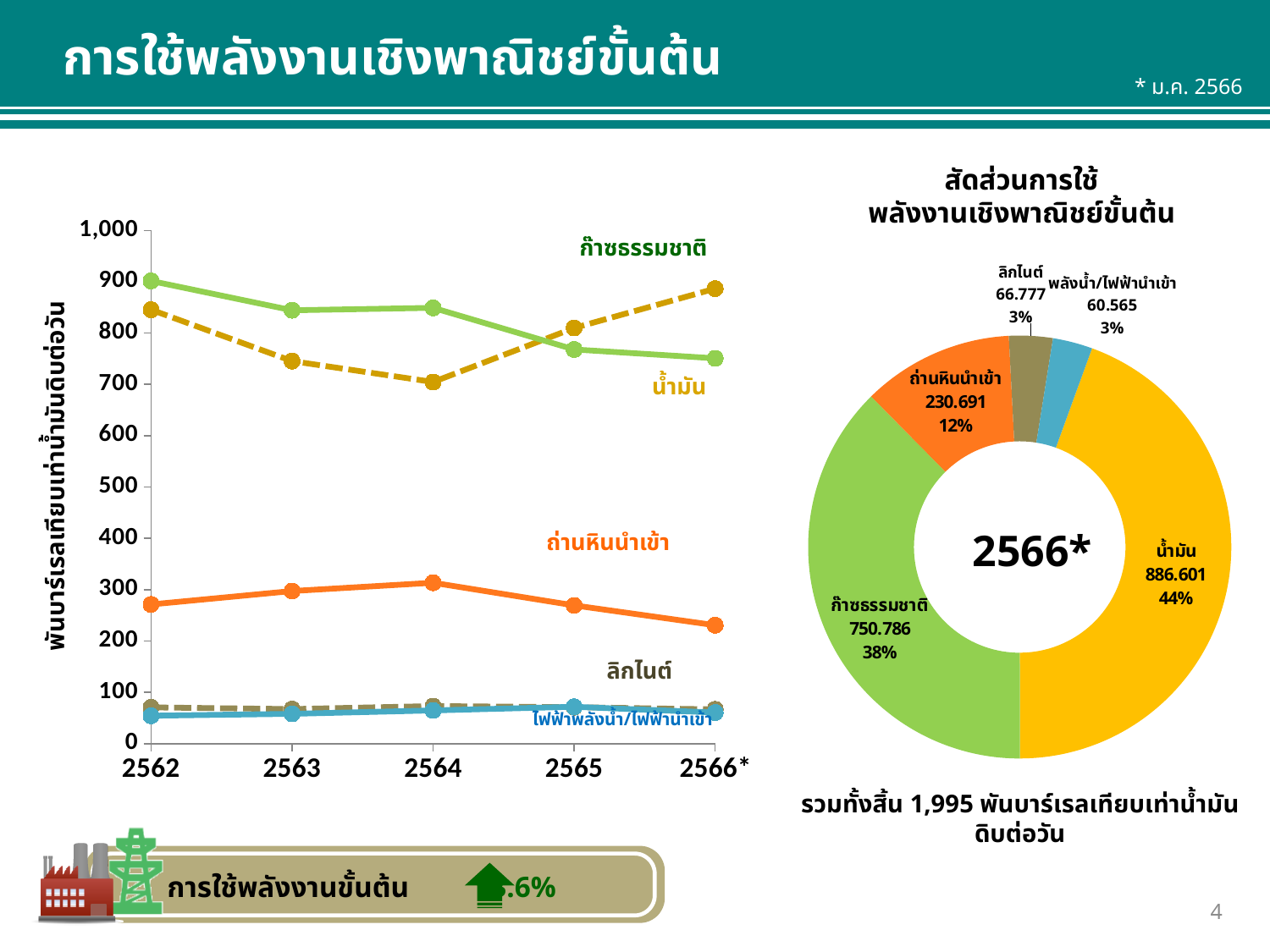
In the donut chart on the right, what share of the total does ก๊าซธรรมชาติ account for? 38% What kind of chart is the chart on the left of the slide? Line chart In the donut chart on the right, which category has the smallest value? พลังน้ำ/ไฟฟ้านำเข้า How many slices does the donut chart on the right have? 5 In the donut chart on the right, what share does ถ่านหินนำเข้า account for? 12% In the line chart on the left, does the value for ถ่านหินนำเข้า rise or fall from 2564 to 2566*? fall In the donut chart on the right, which category has the largest slice? น้ำมัน In the line chart on the left, is the value for ก๊าซธรรมชาติ in 2562 greater or less than 800? greater How many years are shown on the x axis of the line chart on the left? 5 In the donut chart on the right, what is the value shown for น้ำมัน? 886.601 In the donut chart on the right, what is the difference between the values for น้ำมัน and ก๊าซธรรมชาติ? 135.815 In the line chart on the left, which is larger in 2566*: ก๊าซธรรมชาติ or น้ำมัน? น้ำมัน